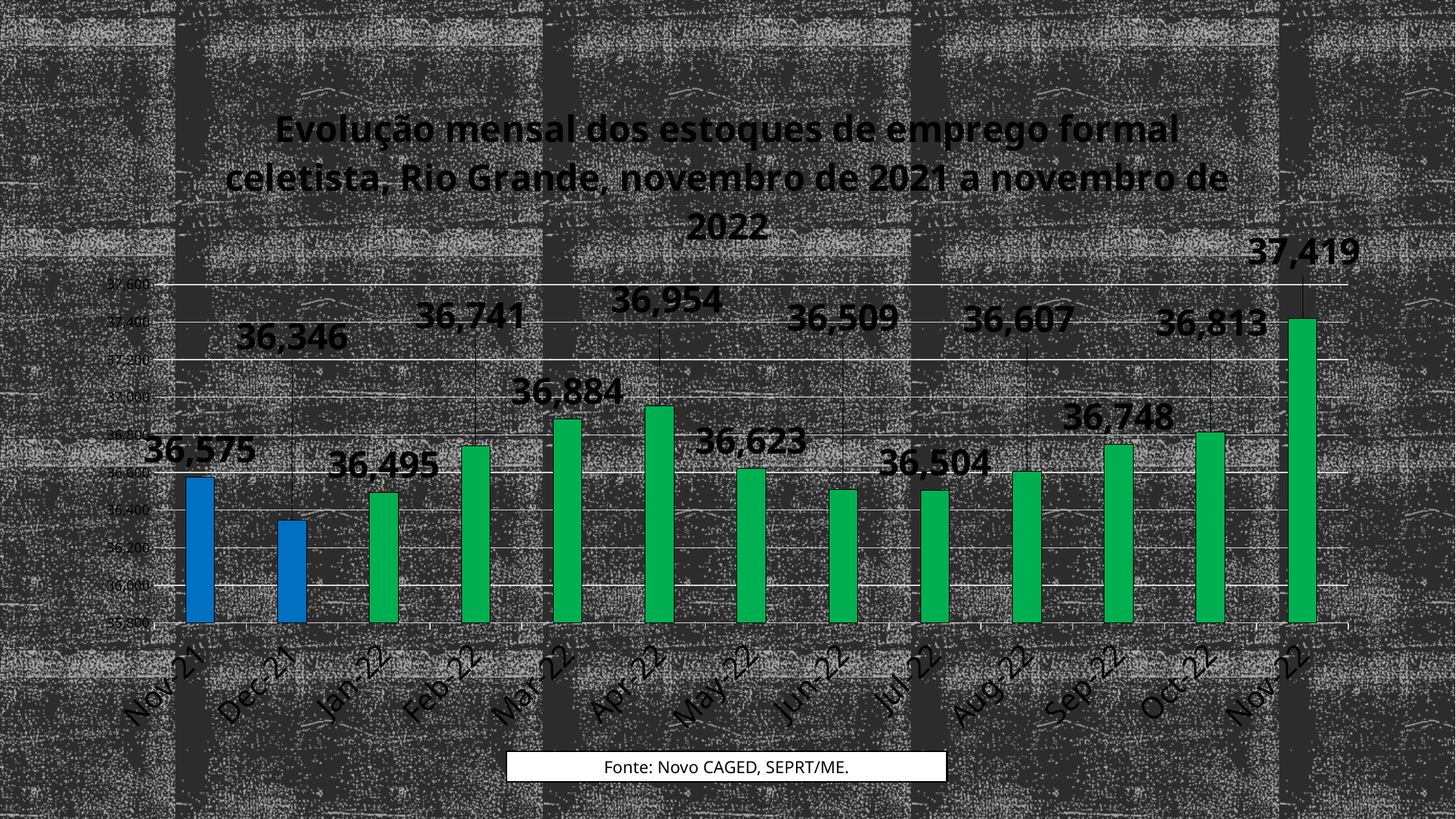
Is the value for Jan-22 greater or less than 36,600? less What is the value for Dec-21? 36,346 What source is cited below the chart? Novo CAGED, SEPRT/ME. What is the value for Nov-22? 37,419 What is the difference between the values for Nov-22 and Nov-21? 844 Which month has the lowest value? Dec-21 Which is larger, the value for Sep-22 or the value for Oct-22? Oct-22 How many months are shown on the x axis? 13 What is the value for Apr-22? 36,954 Which month has the highest value? Nov-22 What kind of chart is shown on the slide? Bar chart What is the difference between the values for Mar-22 and Feb-22? 143